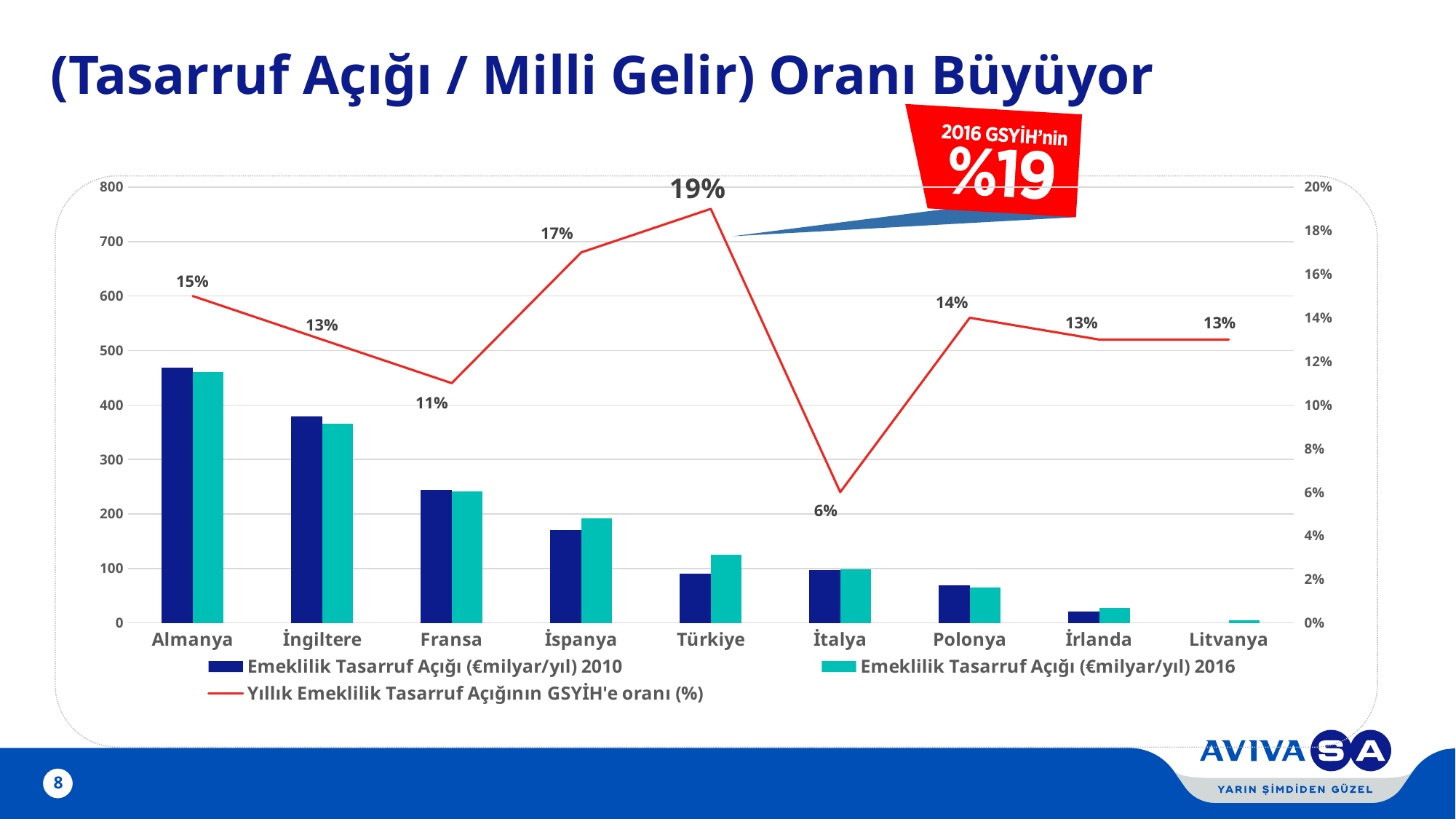
Is the 2010 'Emeklilik Tasarruf Açığı (€milyar/yıl)' bar for Almanya greater or less than 400? greater Which country has the lowest value on the 'Yıllık Emeklilik Tasarruf Açığının GSYİH'e oranı (%)' line? İtalya What is the difference between the GSYİH ratio for Türkiye and for İtalya? 13 percentage points What is the value of the 'Yıllık Emeklilik Tasarruf Açığının GSYİH'e oranı (%)' line for Türkiye? 19% Which country has the highest value on the 'Yıllık Emeklilik Tasarruf Açığının GSYİH'e oranı (%)' line? Türkiye Which has a higher GSYİH ratio on the red line, İspanya or Almanya? İspanya What is the value of the 'Yıllık Emeklilik Tasarruf Açığının GSYİH'e oranı (%)' line for İtalya? 6% How many series does the legend list? 3 What is the value of the 'Yıllık Emeklilik Tasarruf Açığının GSYİH'e oranı (%)' line for Fransa? 11% Is the 2010 'Emeklilik Tasarruf Açığı (€milyar/yıl)' bar for Polonya greater or less than 100? less What kind of chart is shown on the slide? Combined bar and line chart How many countries are shown on the x axis of the chart? 9